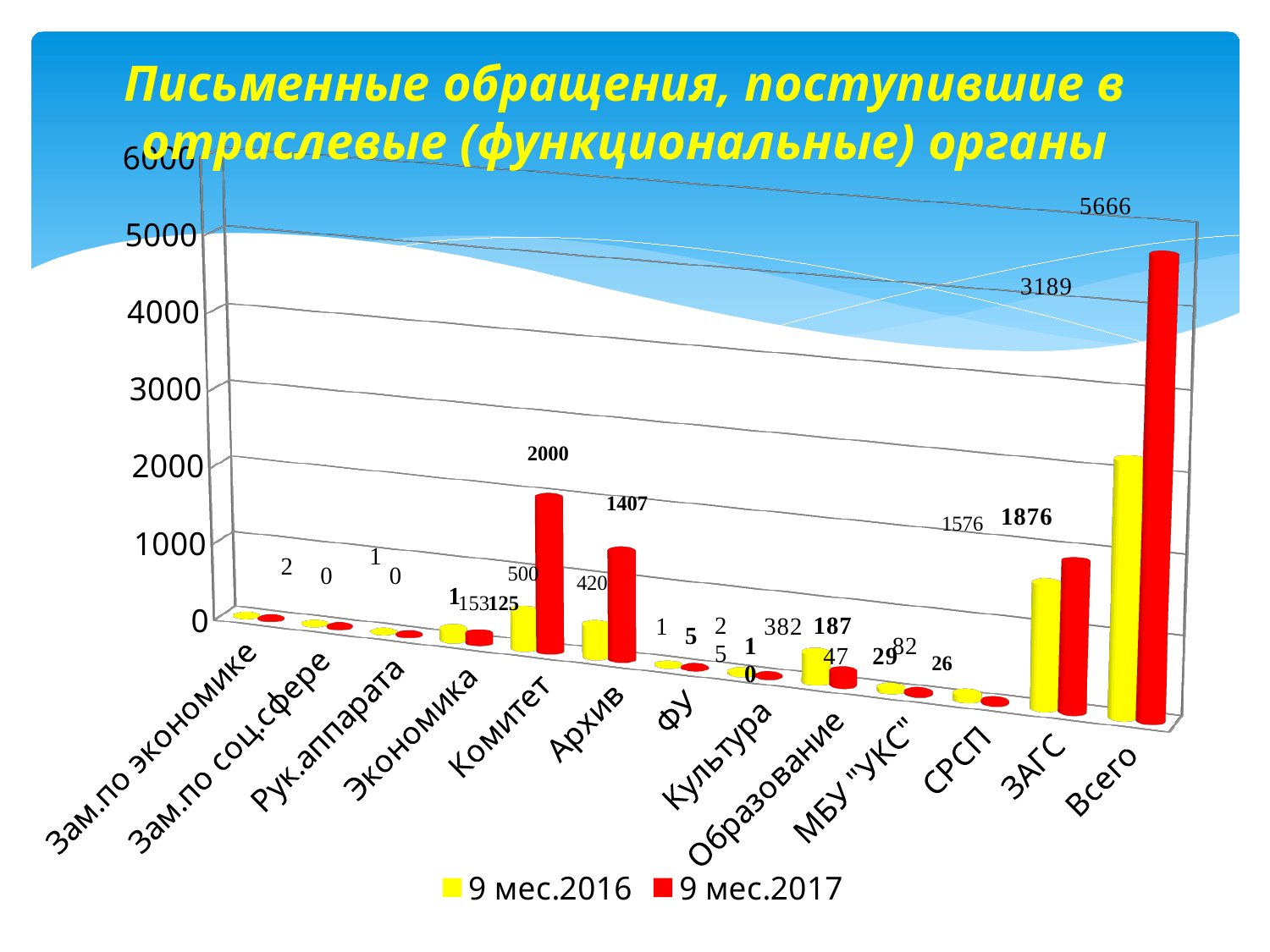
How many series does the legend list? 2 What is the value for Всего in the 9 мес.2017 series? 5666 What is the difference between the 9 мес.2017 and 9 мес.2016 values for ЗАГС? 300 What is the difference between the 9 мес.2017 and 9 мес.2016 values for Всего? 2477 Which is larger in the 9 мес.2017 series: Комитет or Архив? Комитет What is the value for Архив in the 9 мес.2017 series? 1407 How many categories are shown on the x axis? 13 What is the value for Комитет in the 9 мес.2017 series? 2000 Which category has the highest value in the 9 мес.2017 series? Всего What type of chart is shown on the slide? bar chart What is the value for Всего in the 9 мес.2016 series? 3189 What is the value for ЗАГС in the 9 мес.2016 series? 1576